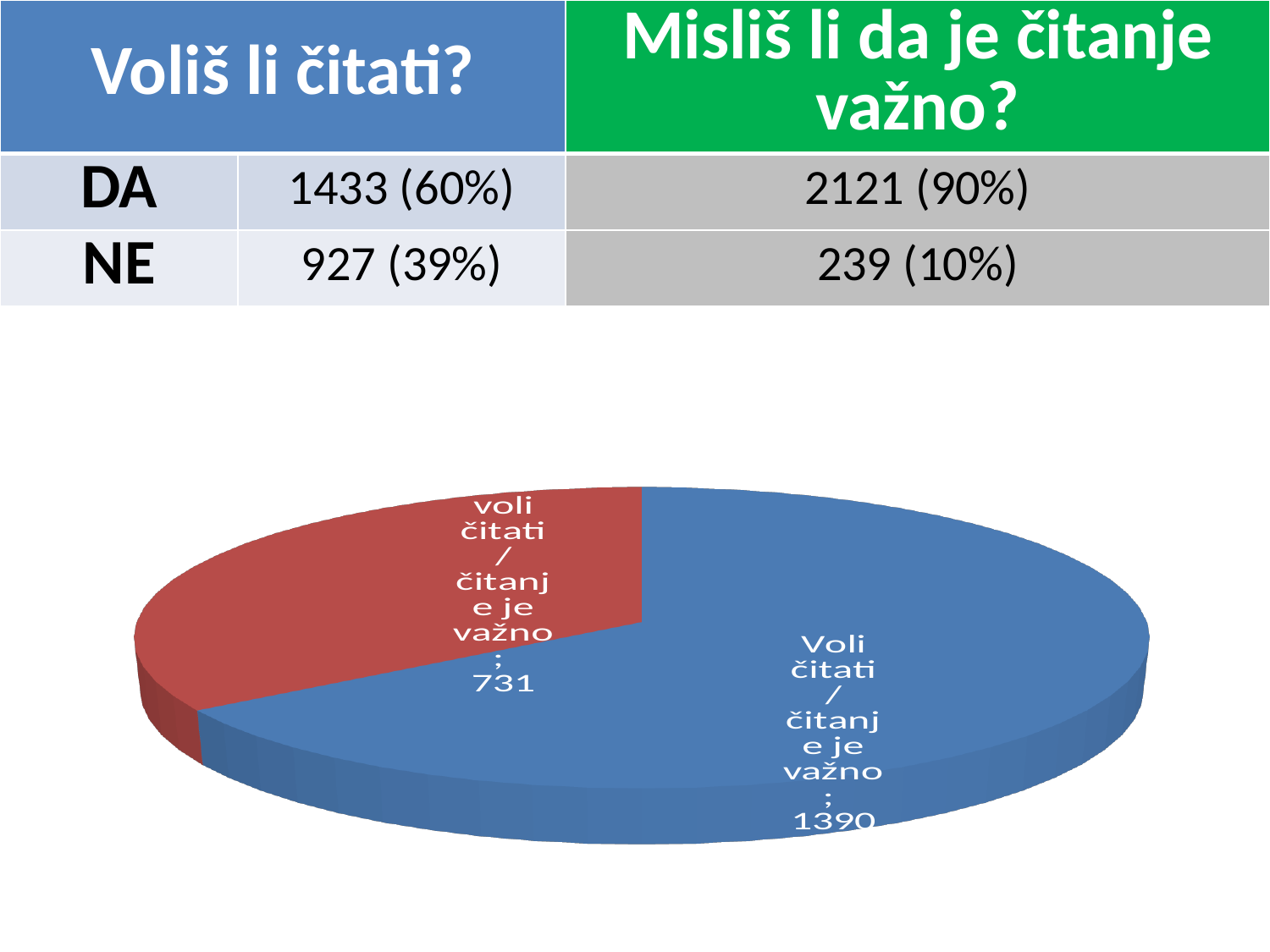
What colour is the slice labelled with the value 731 in the pie chart? red What share of the pie does the blue slice (1390) represent? 65.5% What is the difference between the values of the blue slice and the red slice in the pie chart? 659 What is the total of the two values shown in the pie chart? 2121 Which slice of the pie chart is the largest? the blue slice (1390) Is the blue slice or the red slice of the pie chart larger? the blue slice What share of the pie does the red slice (731) represent? 34.5% What kind of chart is shown on the slide? pie chart Which slice of the pie chart is the smallest? the red slice (731) How many slices does the pie chart have? 2 What value is printed on the blue slice of the pie chart? 1390 What value is printed on the red slice of the pie chart? 731